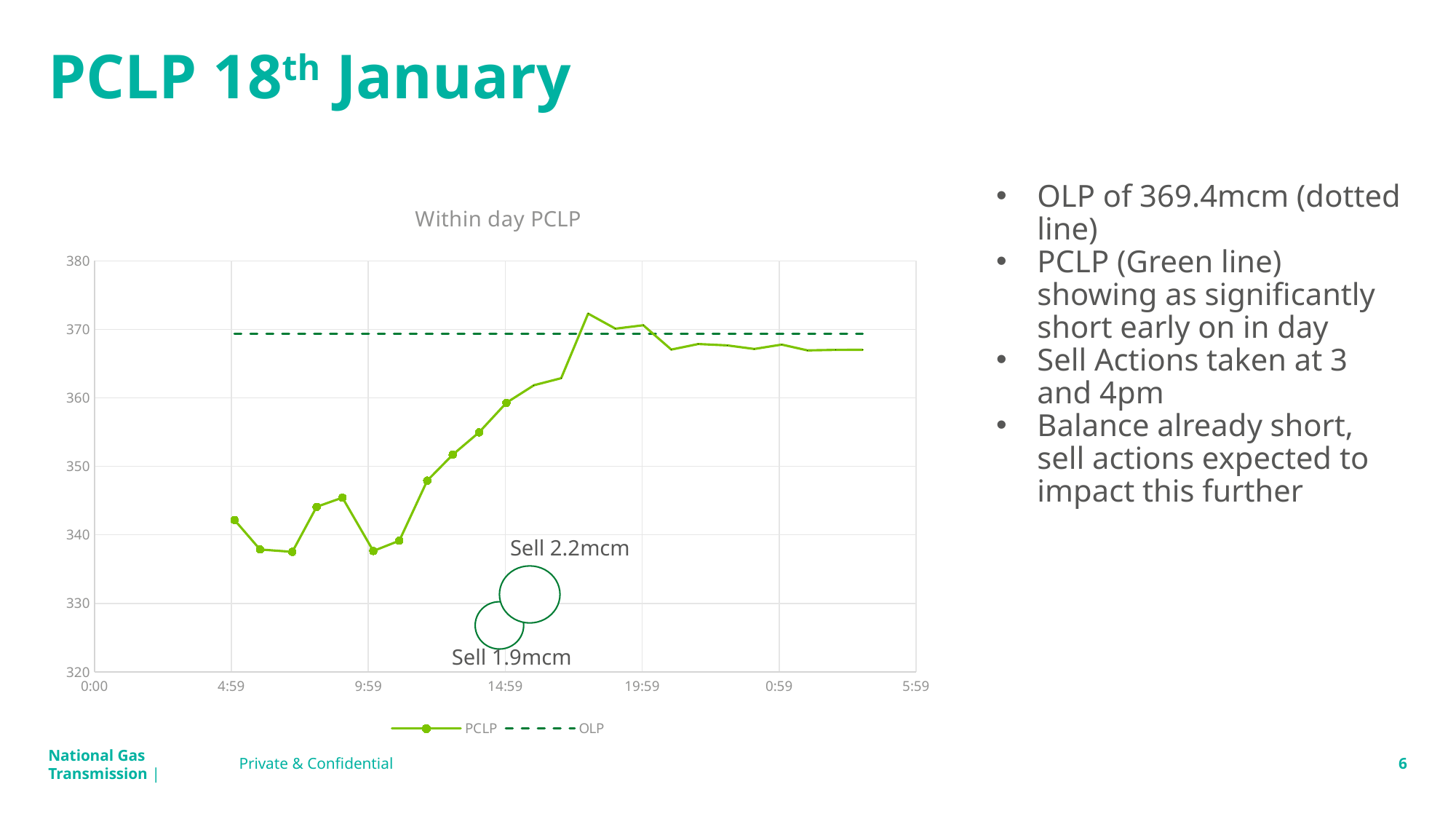
What is the highest value shown on the vertical axis of the chart? 380 Is the PCLP value at 4:59 greater or less than 350? less Which is larger, the PCLP value at 14:59 or the PCLP value at 4:59? 14:59 Is the PCLP value at 9:59 greater or less than 350? less How many time labels are shown on the horizontal axis of the chart? 7 What is the title of the chart? Within day PCLP Is the OLP dotted line greater or less than 360? greater Which series is drawn as a dotted line in the chart? OLP Does the PCLP line rise or fall between 9:59 and 14:59? rise What kind of chart is shown on the slide? line chart How many series does the legend of the chart list? 2